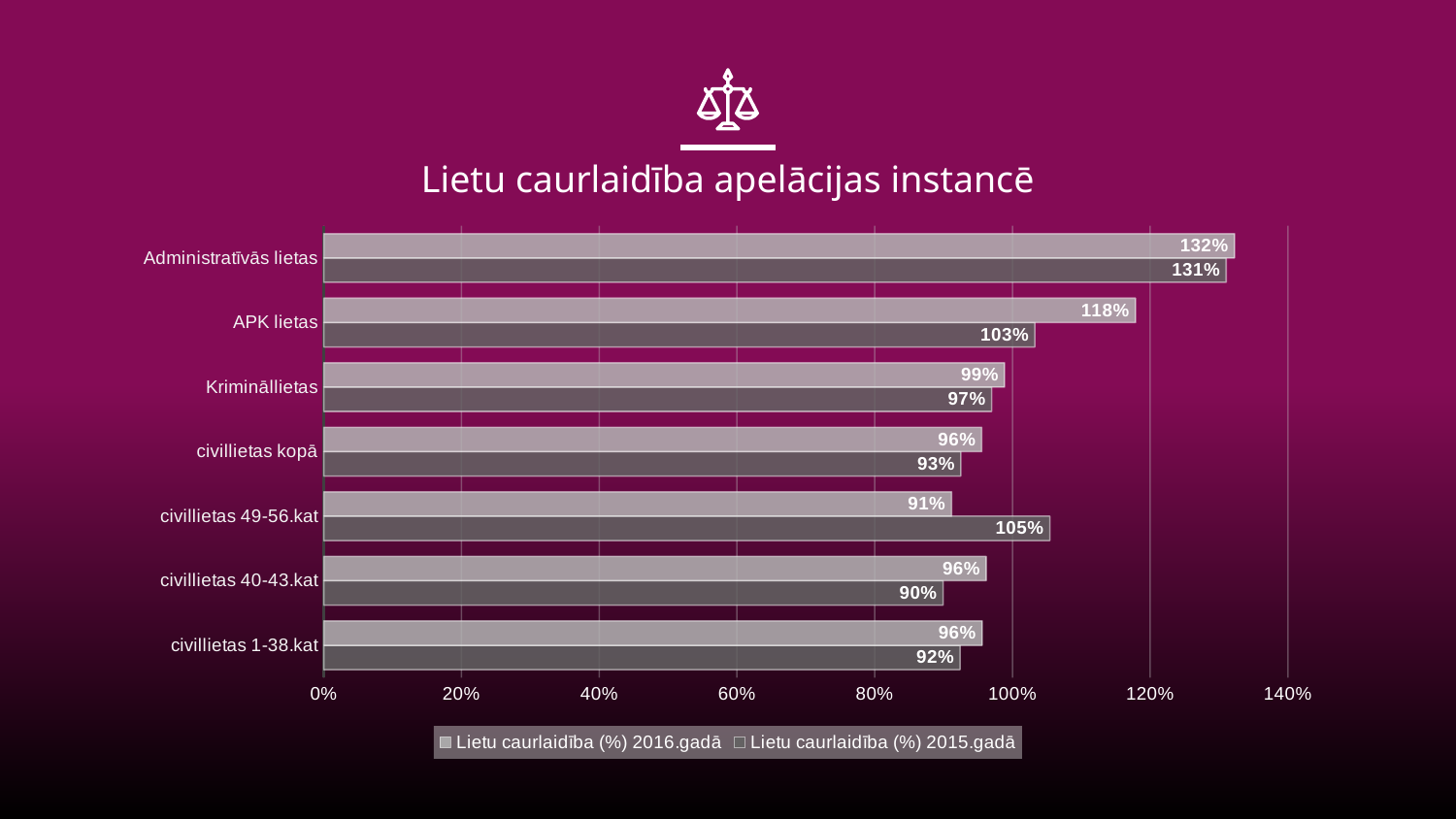
Which category has the highest value for 'Lietu caurlaidība (%) 2016.gadā'? Administratīvās lietas For Administratīvās lietas, what is the difference between the 2015 value and the 2016 value? 1 percentage point How many series does the legend list? 2 What is the title of the chart? Lietu caurlaidība apelācijas instancē How many categories are shown on the chart? 7 What is the value of 'Lietu caurlaidība (%) 2015.gadā' for APK lietas? 118% What is the value of 'Lietu caurlaidība (%) 2016.gadā' for civillietas 40-43.kat? 90% What is the value of 'Lietu caurlaidība (%) 2016.gadā' for Administratīvās lietas? 131% Which category has the lowest value for 'Lietu caurlaidība (%) 2016.gadā'? civillietas 40-43.kat For APK lietas, what is the difference between the 2015 value and the 2016 value? 15 percentage points What type of chart is shown on the slide? bar chart For civillietas 49-56.kat, which series has the larger value: 2016.gadā or 2015.gadā? Lietu caurlaidība (%) 2016.gadā